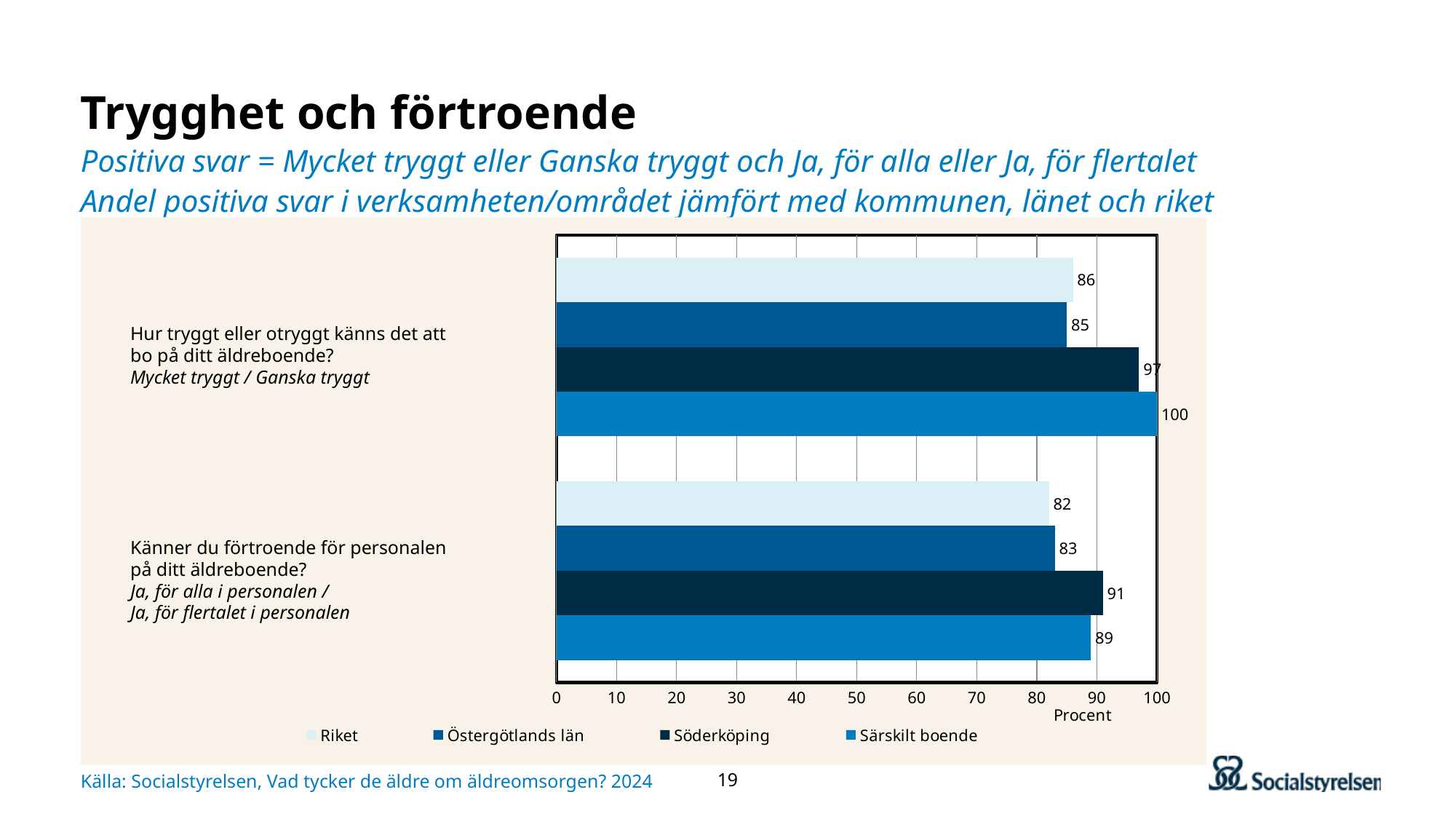
Which series has the lowest value on the question "Hur tryggt eller otryggt känns det att bo på ditt äldreboende?"? Östergötlands län Which series has the highest value on the question "Känner du förtroende för personalen på ditt äldreboende?"? Söderköping How many series does the legend list? 4 What is the value for Söderköping on the question "Känner du förtroende för personalen på ditt äldreboende?"? 91 What is the value for Särskilt boende on the question "Hur tryggt eller otryggt känns det att bo på ditt äldreboende?"? 100 What is the difference between Särskilt boende and Riket on the question "Hur tryggt eller otryggt känns det att bo på ditt äldreboende?"? 14 Which is larger on the question "Känner du förtroende för personalen på ditt äldreboende?": Söderköping or Särskilt boende? Söderköping What is the value for Östergötlands län on the question "Hur tryggt eller otryggt känns det att bo på ditt äldreboende?"? 85 What unit is shown on the horizontal axis of the chart? Procent What is the difference between Söderköping and Särskilt boende on the question "Känner du förtroende för personalen på ditt äldreboende?"? 2 What is the value for Riket on the question "Känner du förtroende för personalen på ditt äldreboende?"? 82 What kind of chart is shown on the slide? Bar chart